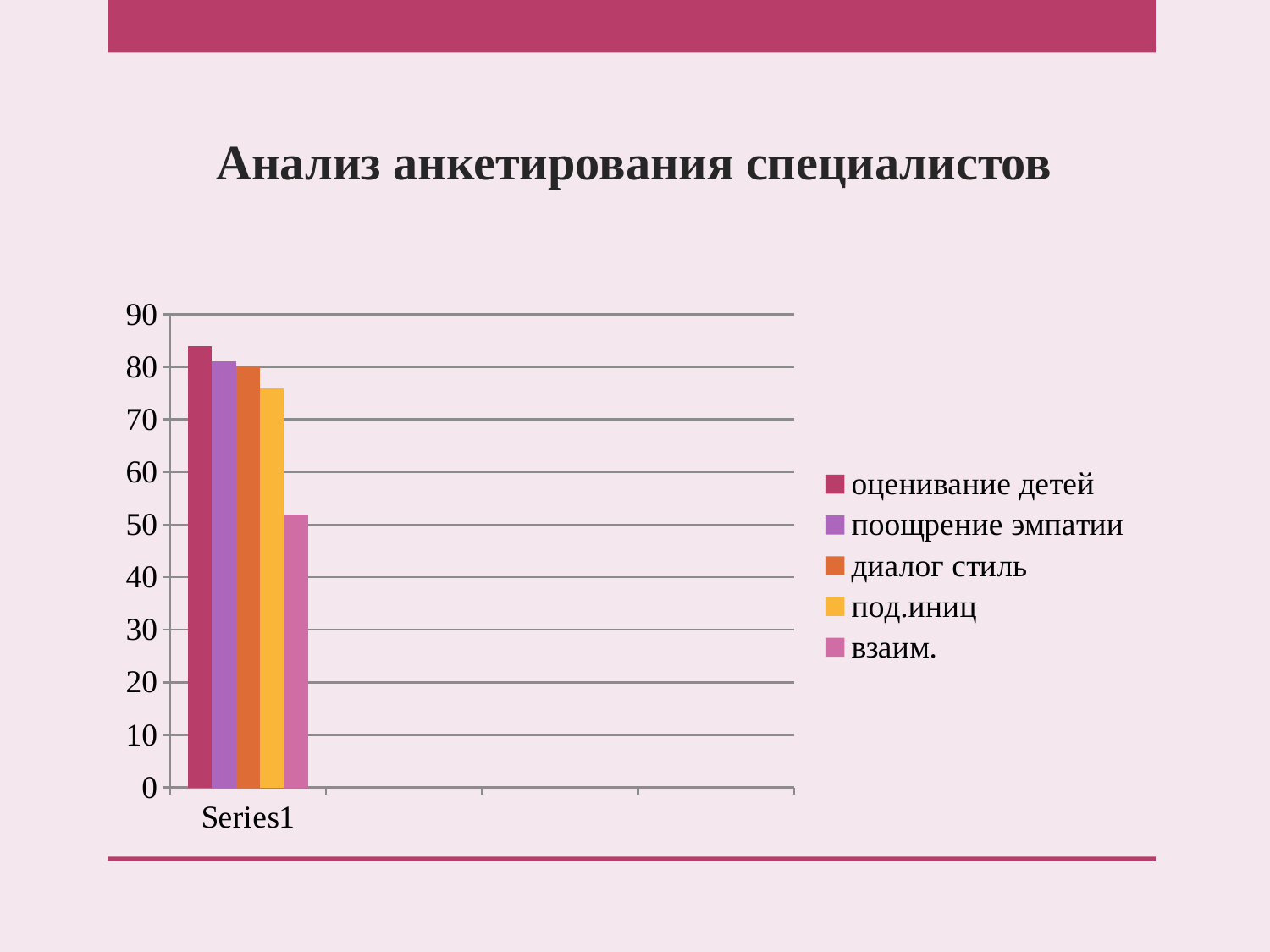
Is the value for под.иниц greater or less than 70? greater How many series does the legend list? 5 Which series has the lowest bar? взаим. Which is larger, the value for под.иниц or the value for взаим.? под.иниц What is the title of the slide above the chart? Анализ анкетирования специалистов What kind of chart is shown on the slide? bar chart Is the value for под.иниц greater or less than 80? less Which series has the highest bar? оценивание детей Is the value for взаим. greater or less than 60? less What is the label of the category on the x axis? Series1 How many categories are labelled on the x axis? 1